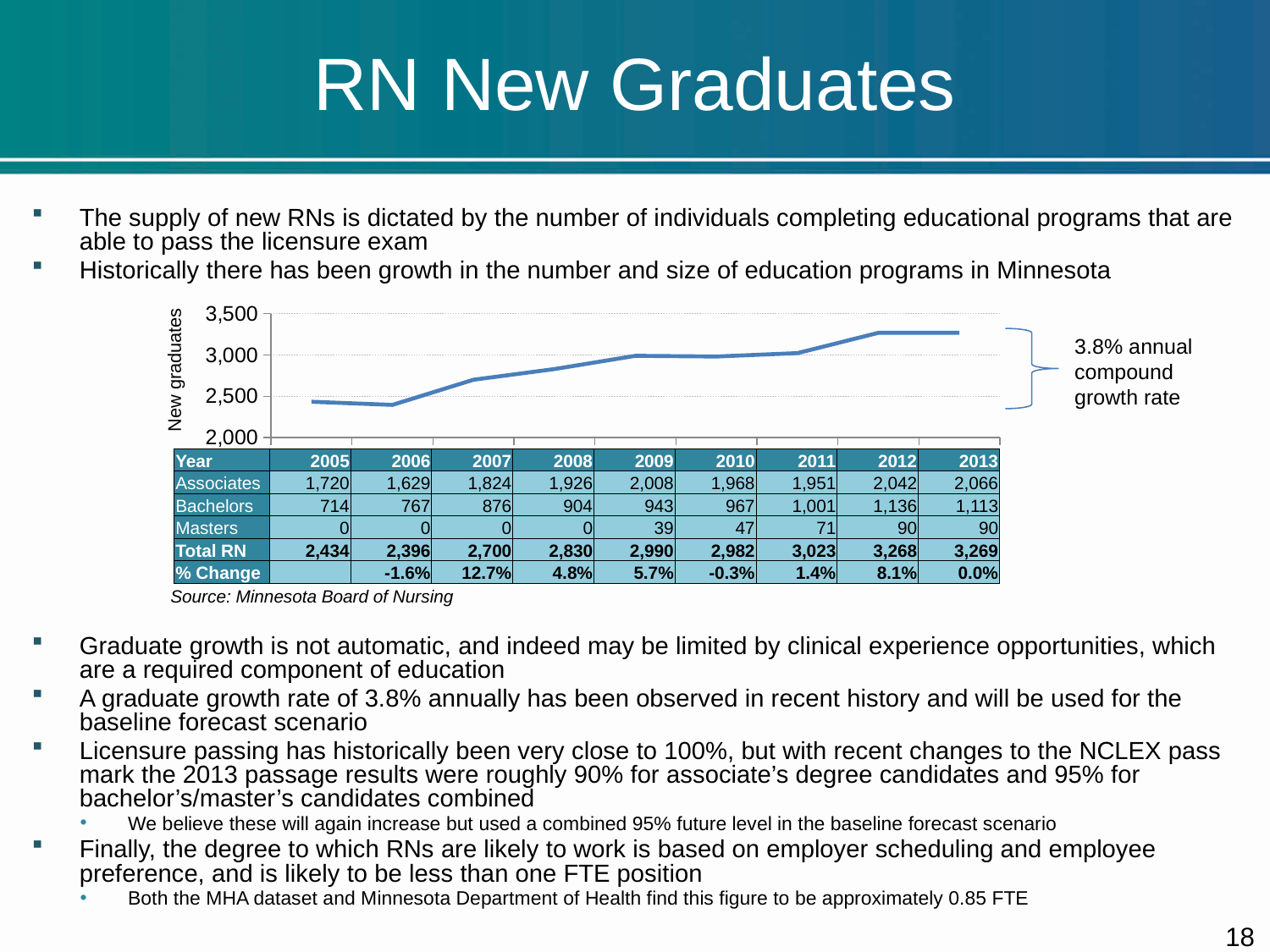
How many years are plotted on the x axis? 9 What is the label on the y axis? New graduates Is the Total RN value for 2009 larger than the value for 2010? yes What is the Total RN value for 2005? 2,434 Do the Total RN values generally rise or fall from 2005 to 2013? rise What is the Total RN value for 2013? 3,269 What kind of chart is shown on the slide? line chart Which year has the lowest Total RN value? 2006 What is the difference between the Total RN values for 2012 and 2011? 245 Is the Total RN value for 2008 greater or less than 3,000? less Which year has the highest Total RN value? 2013 What annual compound growth rate is annotated next to the chart? 3.8%